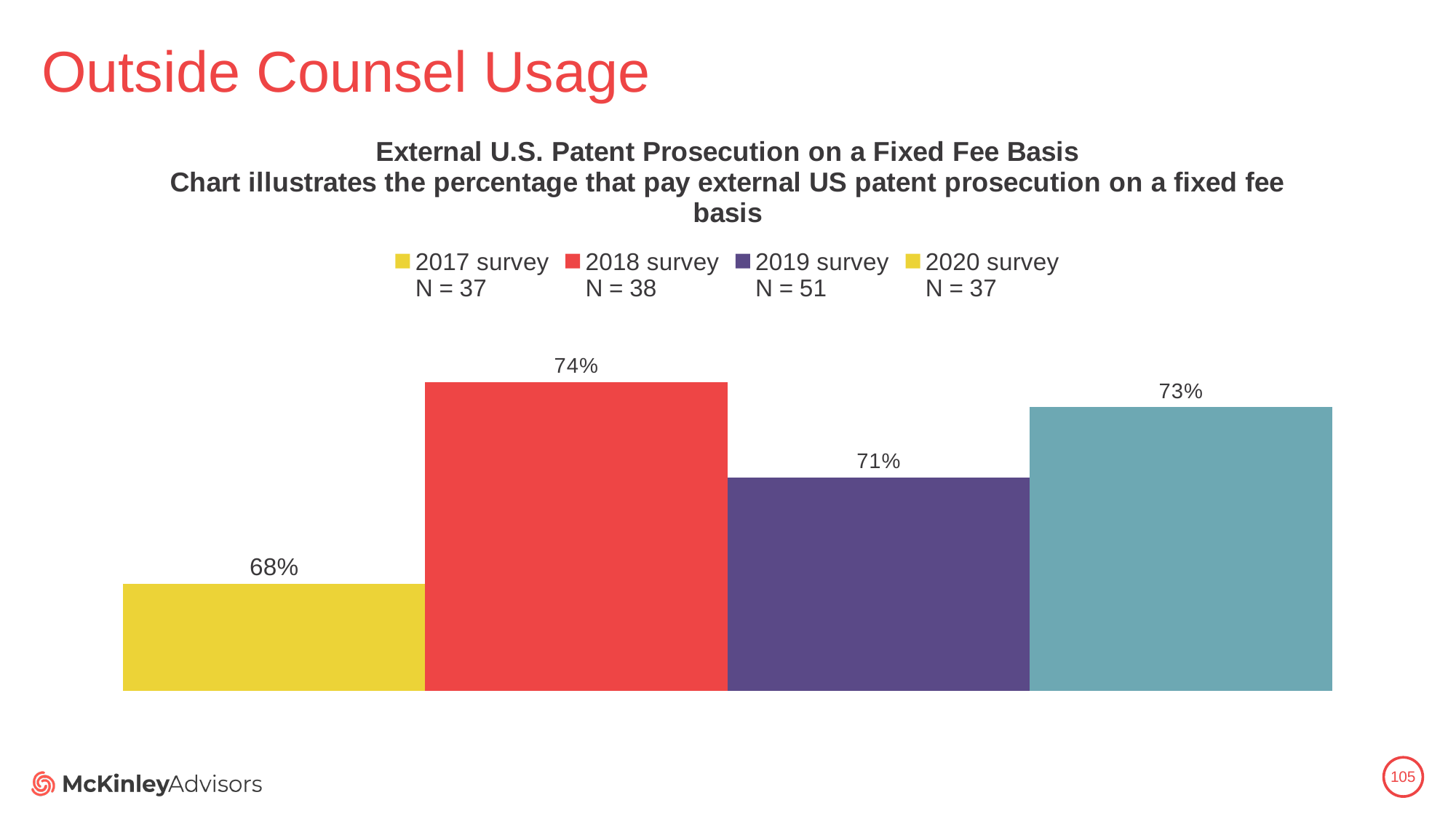
What is the difference in percentage points between the 2020 survey and the 2019 survey? 2 How many series does the legend list? 4 What is the difference in percentage points between the 2018 survey and the 2017 survey? 6 Which is larger, the value for the 2019 survey or the value for the 2017 survey? 2019 survey What kind of chart is shown on the slide? Bar chart Which survey year has the highest percentage paying external US patent prosecution on a fixed fee basis? 2018 survey What percentage is shown for the 2019 survey? 71% What is the sample size (N) shown for the 2019 survey in the legend? N = 51 What percentage is shown for the 2018 survey? 74% Which survey year has the lowest percentage paying external US patent prosecution on a fixed fee basis? 2017 survey What percentage is shown for the 2017 survey? 68% What percentage is shown for the 2020 survey? 73%